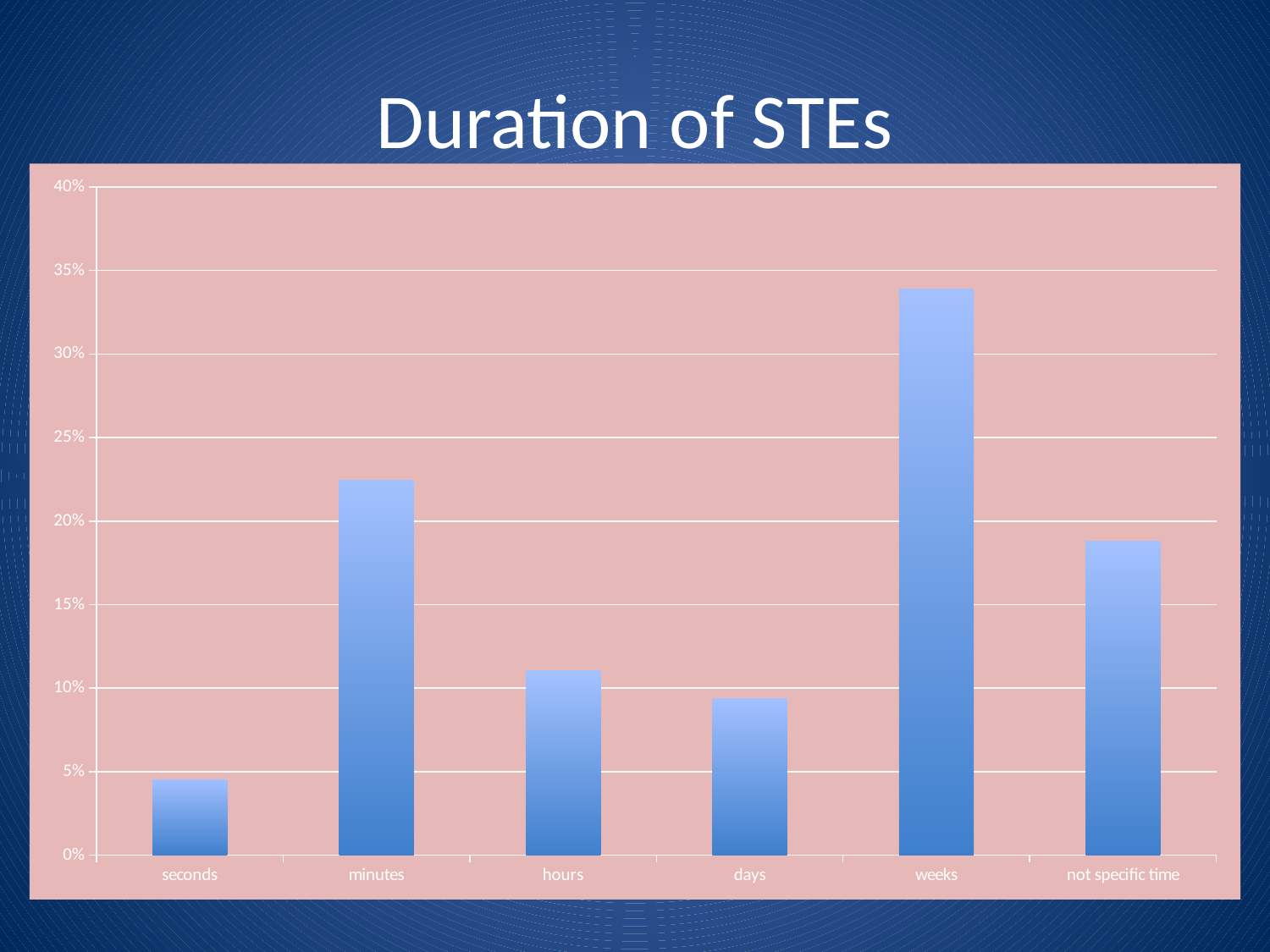
Is the value for not specific time greater or less than 20%? less Which is larger, the value for minutes or the value for hours? minutes What is the title of the chart? Duration of STEs Is the value for minutes greater or less than 20%? greater Which category has the highest value? weeks Is the value for days greater or less than 10%? less How many categories are shown on the x axis? 6 What kind of chart is shown on the slide? bar chart Which is larger, the value for weeks or the value for not specific time? weeks Which category has the lowest value? seconds